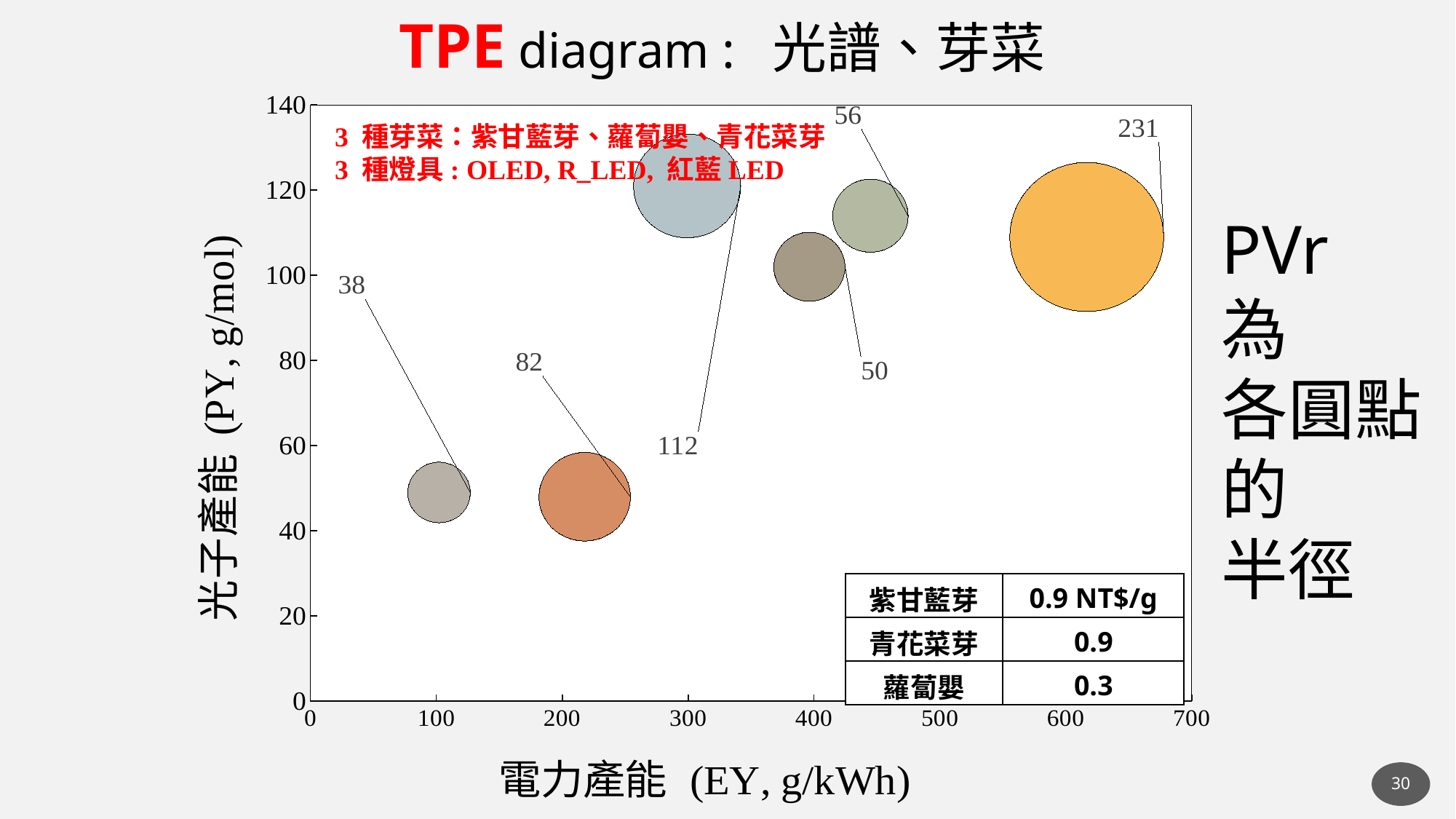
What is the maximum value shown on the y axis of the chart? 140 Which bubble label is larger, 112 or 82? 112 According to the slide, what does the radius of each bubble represent? PVr What is the label of the x axis of the chart? 電力產能 (EY, g/kWh) Is the 電力產能 (EY) value of the bubble labelled 231 greater or less than 500? greater Is the 光子產能 (PY) value of the bubble labelled 112 greater or less than 100? greater How many bubbles are plotted on the chart? 6 What kind of chart is shown on the slide? bubble chart What is the largest PVr value labelled on a bubble in the chart? 231 Is the 光子產能 (PY) value of the bubble labelled 38 greater or less than 80? less What is the smallest PVr value labelled on a bubble in the chart? 38 What is the difference between the largest bubble label (231) and the smallest bubble label (38)? 193